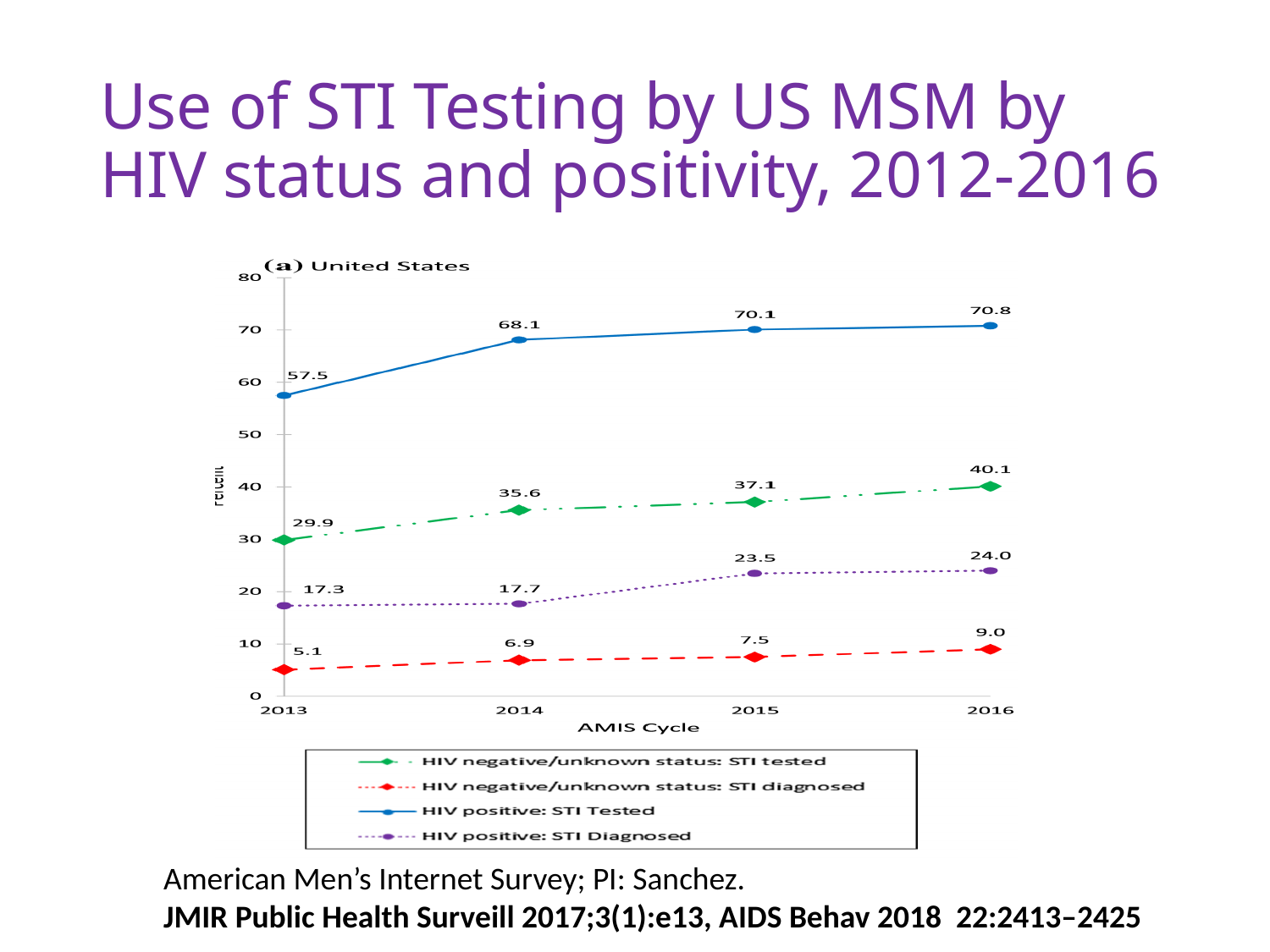
Does the HIV negative/unknown status: STI diagnosed series rise or fall from 2013 to 2016? Rise In which year is the HIV negative/unknown status: STI tested series lowest? 2013 How many series does the legend list? 4 What is the value for HIV positive: STI Tested in 2016? 70.8 What is the value for HIV negative/unknown status: STI tested in 2014? 35.6 How many AMIS Cycle years are plotted on the x axis? 4 In which year is the HIV positive: STI Tested series highest? 2016 What is the value for HIV positive: STI Diagnosed in 2015? 23.5 Which is larger in 2015: HIV positive: STI Diagnosed or HIV negative/unknown status: STI diagnosed? HIV positive: STI Diagnosed What is the difference between the HIV positive: STI Tested values in 2016 and 2013? 13.3 What is the value for HIV negative/unknown status: STI diagnosed in 2013? 5.1 What kind of chart is shown on the slide? Line chart